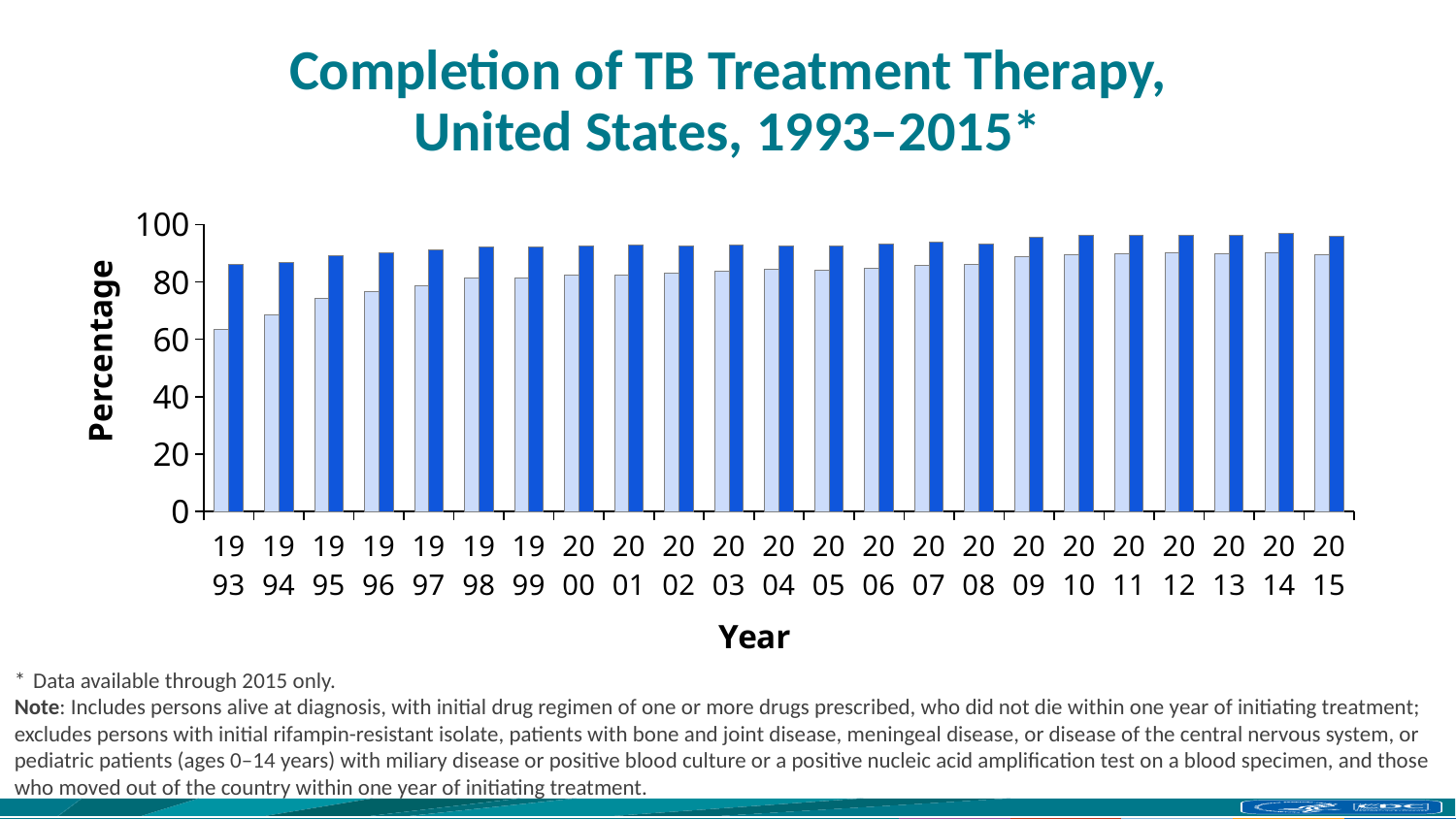
What is the label of the y axis? Percentage What is the title of the chart? Completion of TB Treatment Therapy, United States, 1993–2015* Is the value of the light blue bar for 1993 greater or less than 80? less Do the light blue bars generally rise or fall from 1993 to 2015? rise Is the value of the dark blue bar for 1993 greater or less than 80? greater How many years are shown along the x axis of the chart? 23 Is the value of the light blue bar for 2015 greater or less than 80? greater Which is larger, the light blue bar for 1993 or the light blue bar for 2000? the light blue bar for 2000 Which year has the lowest value for the light blue bars? 1993 In 1993, which bar is larger, the light blue bar or the dark blue bar? the dark blue bar What kind of chart is shown on the slide? bar chart